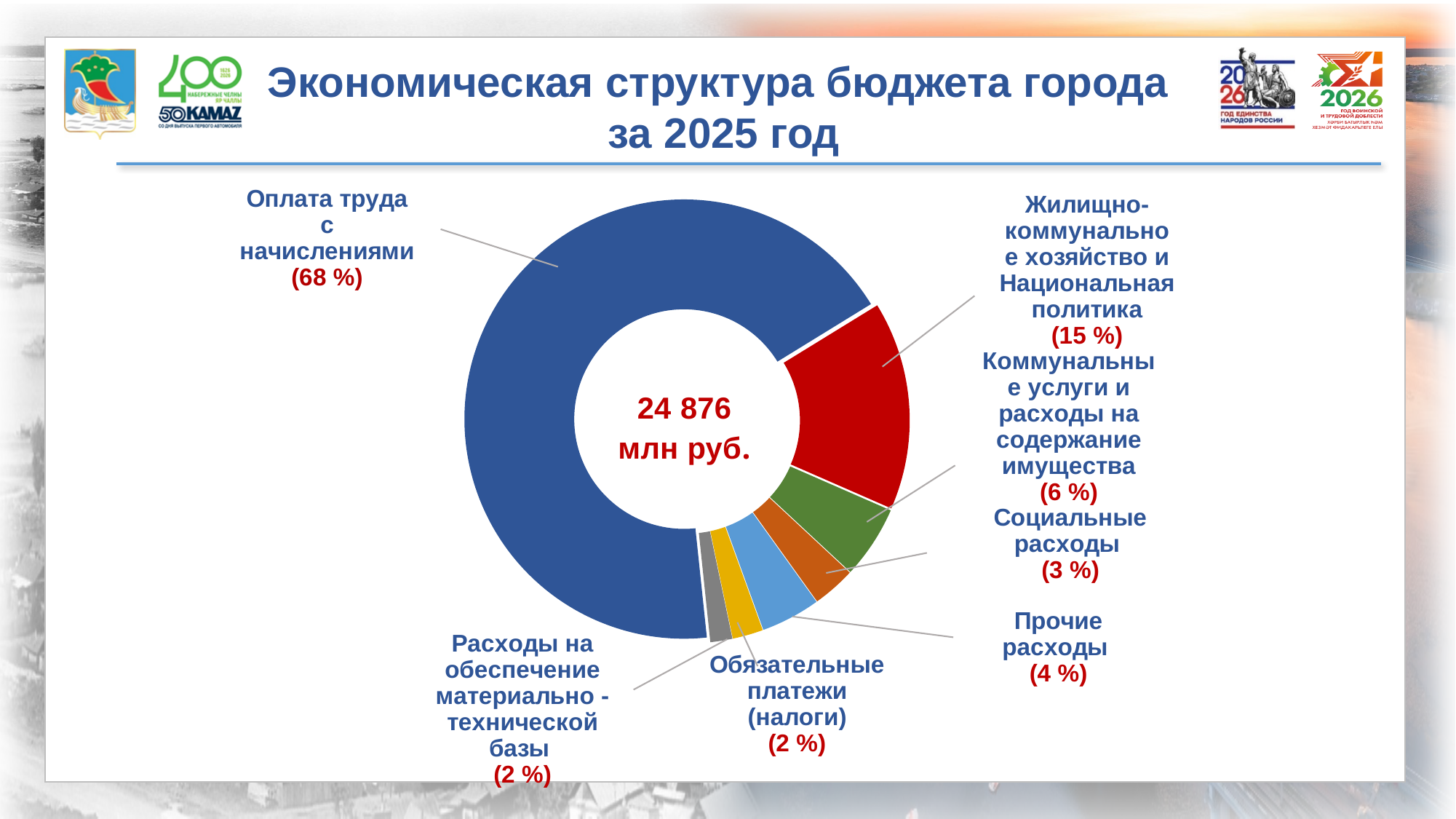
What share is shown for "Коммунальные услуги и расходы на содержание имущества"? 6 % What share of the budget is labelled for "Оплата труда с начислениями"? 68 % Which category has the largest share of the budget? Оплата труда с начислениями What is the difference in percentage points between "Оплата труда с начислениями" and "Жилищно-коммунальное хозяйство и Национальная политика"? 53 What is the title of the slide? Экономическая структура бюджета города за 2025 год What kind of chart is shown on the slide? Pie (donut) chart What share is shown for "Социальные расходы"? 3 % How many categories are shown in the chart? 7 What share is shown for "Прочие расходы"? 4 % What total value is printed in the centre of the chart? 24 876 млн руб. What share is shown for "Жилищно-коммунальное хозяйство и Национальная политика"? 15 % Which is larger: the share for "Прочие расходы" or the share for "Социальные расходы"? Прочие расходы